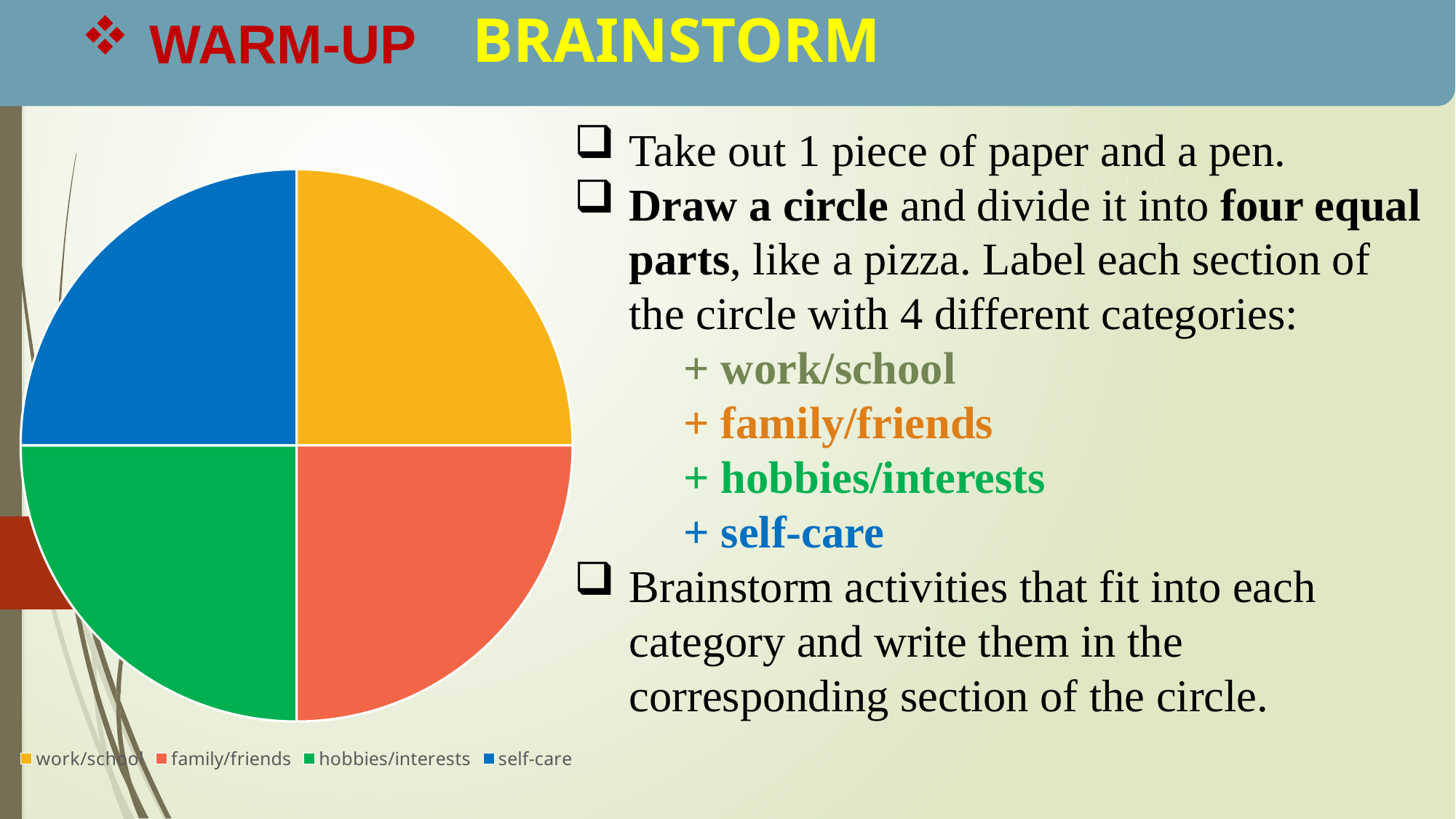
Is the family/friends slice larger or smaller than the hobbies/interests slice? equal How many slices does the pie chart have? 4 What share of the pie does the self-care slice take? 25% Which legend entry is listed first in the pie chart's legend? work/school Which category is shown in blue in the pie chart? self-care Are the four slices of the pie chart equal in size? yes What share of the pie does the work/school slice take? 25% Which category is shown in green in the pie chart? hobbies/interests What kind of chart is shown on the slide? pie chart How many entries does the legend of the pie chart list? 4